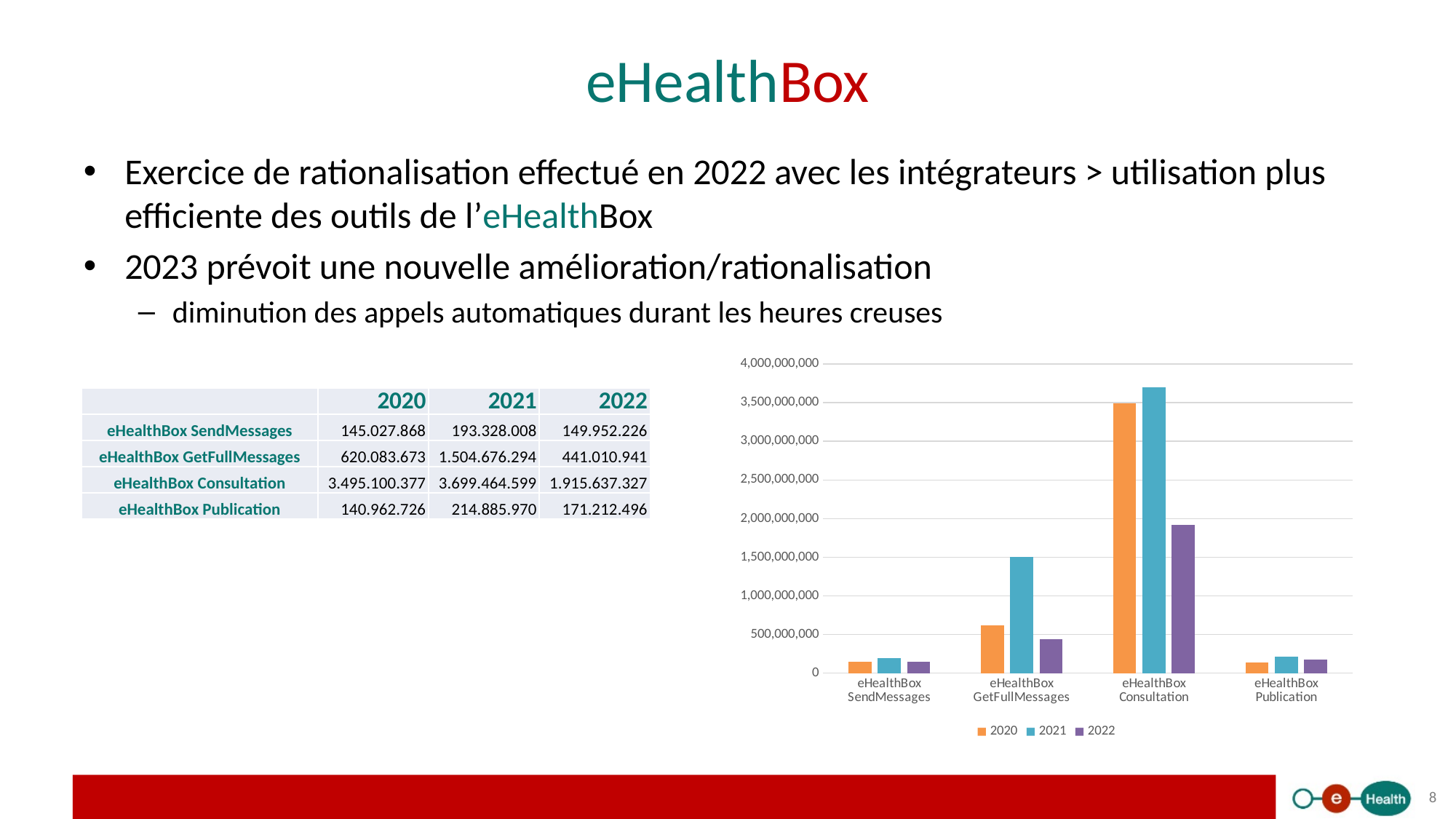
For eHealthBox Consultation, does the value rise or fall from 2021 to 2022? fall According to the table on the slide, what is the 2020 value for eHealthBox Consultation? 3.495.100.377 How many series does the chart's legend list? 3 Which colour represents the 2022 series in the chart's legend? purple Is the 2021 value for eHealthBox Consultation greater or less than 3,500,000,000? greater Using the table values, what is the difference between the 2021 and 2022 values for eHealthBox Consultation? 1.783.827.272 Which category has the highest 2021 value in the chart? eHealthBox Consultation Is the 2021 value for eHealthBox GetFullMessages greater or less than 1,000,000,000? greater How many categories are shown on the x axis of the chart? 4 Is the 2022 value for eHealthBox Consultation greater or less than 2,500,000,000? less For eHealthBox GetFullMessages, which is larger: the 2020 value or the 2022 value? 2020 What kind of chart is shown on the slide? bar chart